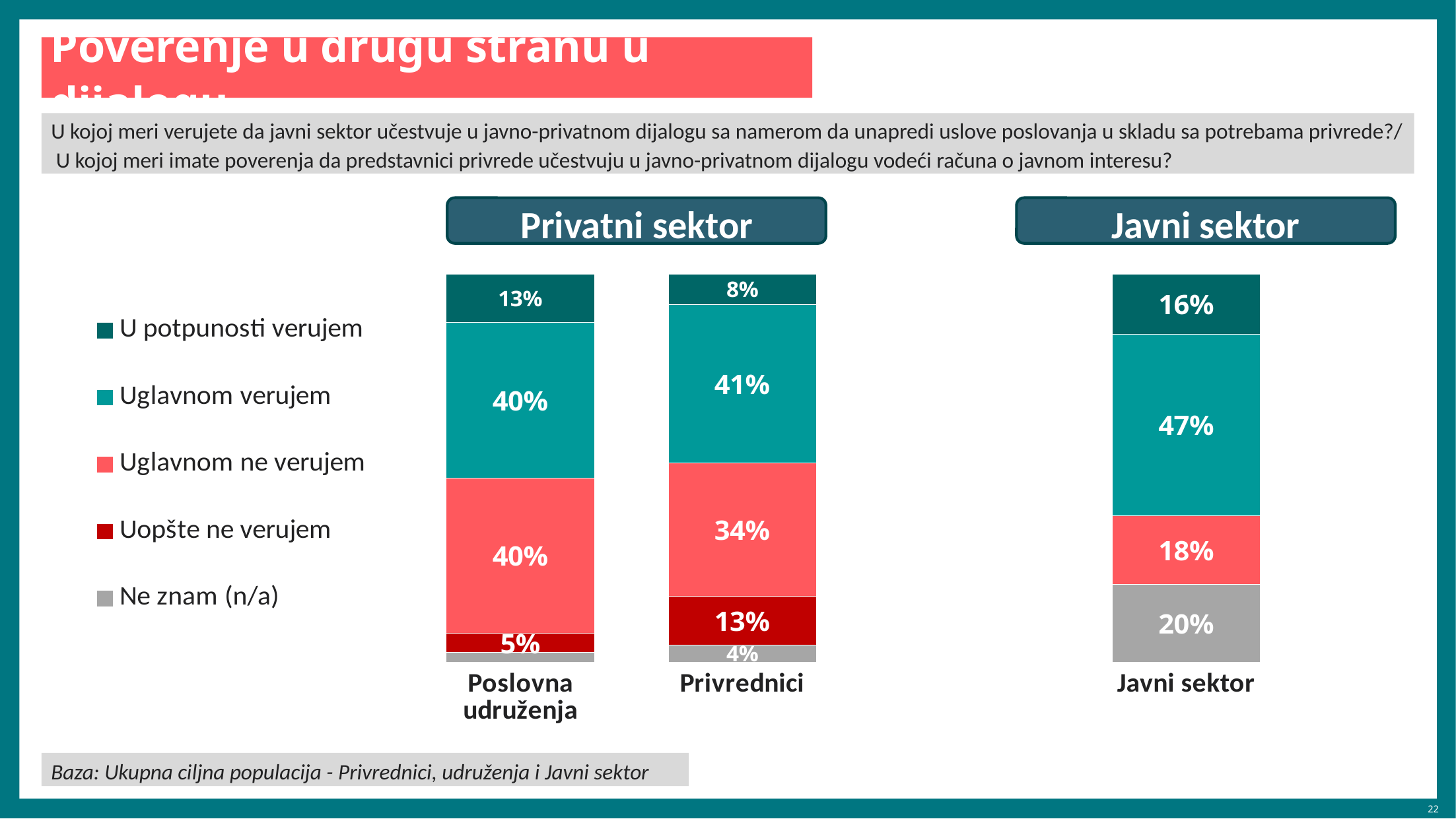
What percentage of Javni sektor respondents answered "Uglavnom verujem"? 47% What kind of chart is shown on the slide? Stacked bar chart What is the "Ne znam (n/a)" value for Javni sektor? 20% Which category has the highest "Uglavnom verujem" value? Javni sektor Which category has the lowest "U potpunosti verujem" value? Privrednici What is the "Ne znam (n/a)" value for Privrednici? 4% What is the "U potpunosti verujem" value for Poslovna udruženja? 13% Which has a larger "Uglavnom verujem" value, Poslovna udruženja or Privrednici? Privrednici What is the difference between the "Uglavnom ne verujem" values for Poslovna udruženja and Javni sektor? 22 percentage points What is the "Uopšte ne verujem" value for Privrednici? 13% How many categories (bars) are shown in the chart? 3 How many series does the legend list? 5